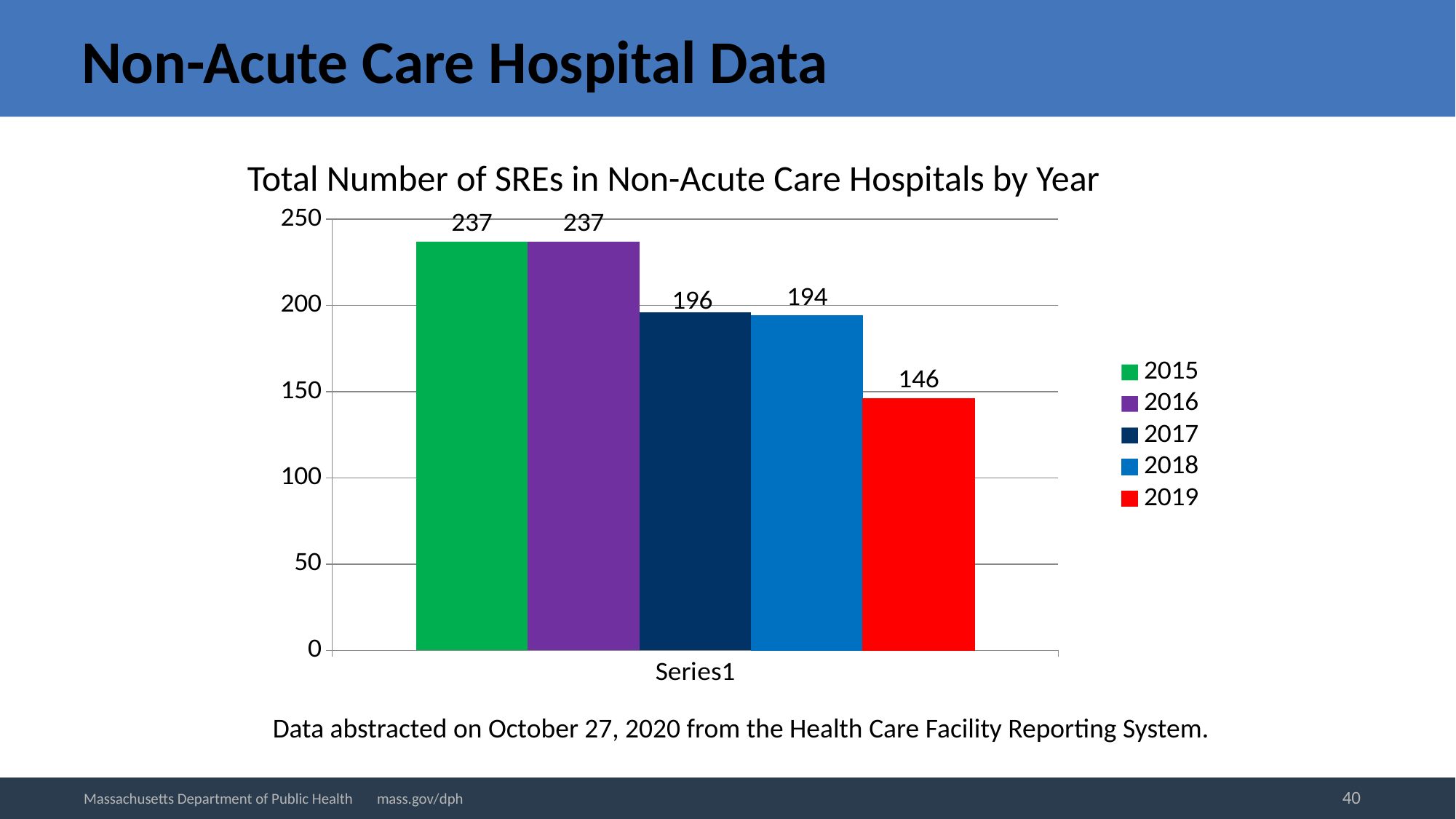
What is the value for 2015? 237 Do the values rise or fall from 2015 to 2019? fall How many series does the legend list? 5 What is the title of the chart? Total Number of SREs in Non-Acute Care Hospitals by Year What is the value for 2019? 146 What kind of chart is shown? bar chart What is the difference between the values for 2017 and 2018? 2 What is the difference between the values for 2015 and 2019? 91 Which is larger, the value for 2016 or the value for 2018? 2016 Which year has the lowest value? 2019 Is the value for 2019 greater or less than 150? less What is the value for 2017? 196